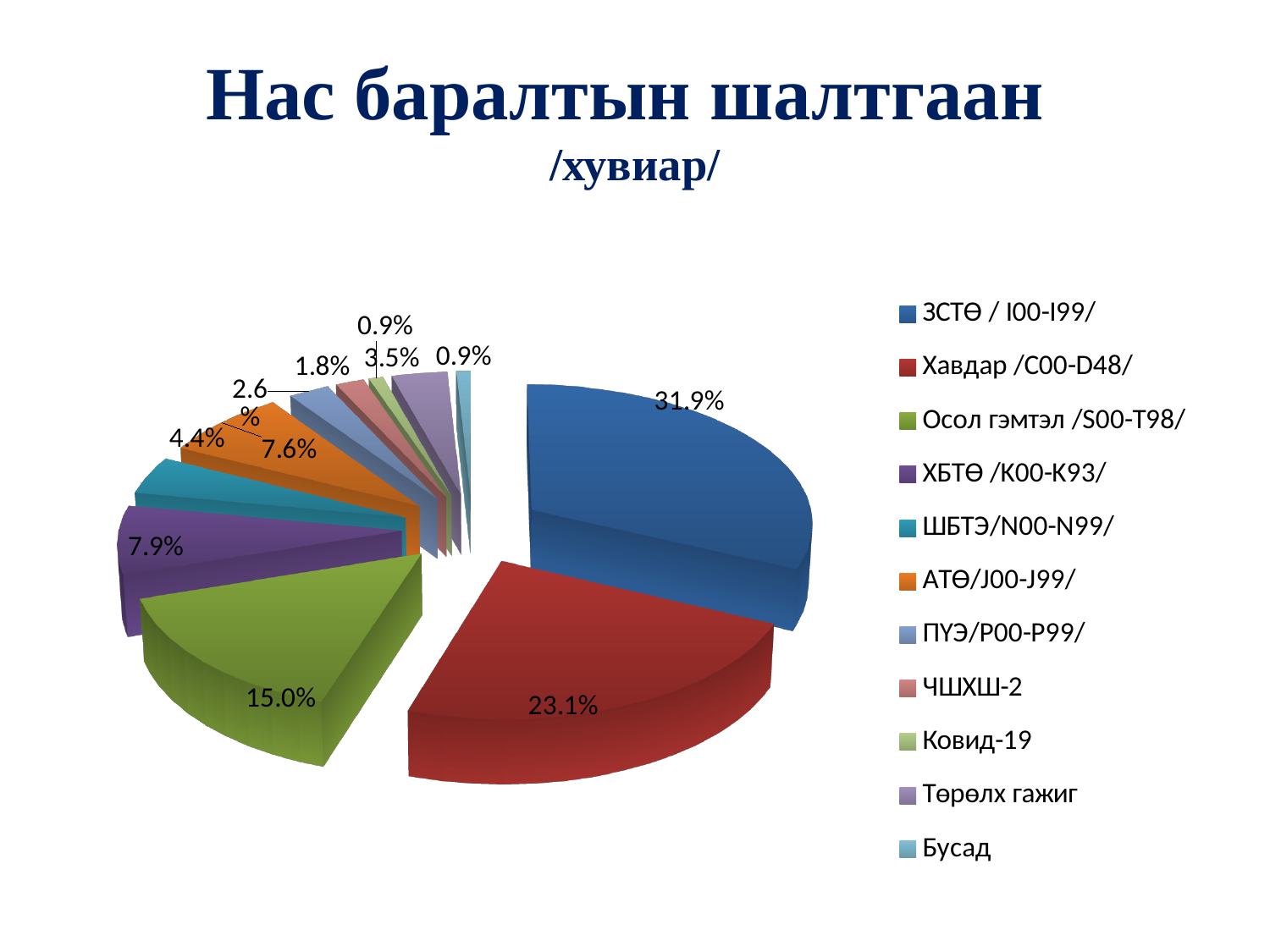
What percentage is shown for ХБТӨ /K00-K93/? 7.9% What percentage is shown for ЗСТӨ / I00-I99/? 31.9% What colour is the slice for Хавдар /C00-D48/? Red What type of chart is shown on the slide? Pie chart Which is larger, the share for ХБТӨ /K00-K93/ or the share for АТӨ/J00-J99/? ХБТӨ /K00-K93/ Which category has the largest share of the pie? ЗСТӨ / I00-I99/ What percentage is shown for АТӨ/J00-J99/? 7.6% What percentage is shown for Хавдар /C00-D48/? 23.1% What percentage is shown for Осол гэмтэл /S00-T98/? 15.0% What is the title of the chart on the slide? Нас баралтын шалтгаан /хувиар/ How many categories does the pie chart have? 11 What is the difference between the shares of ЗСТӨ / I00-I99/ and Хавдар /C00-D48/? 8.8%